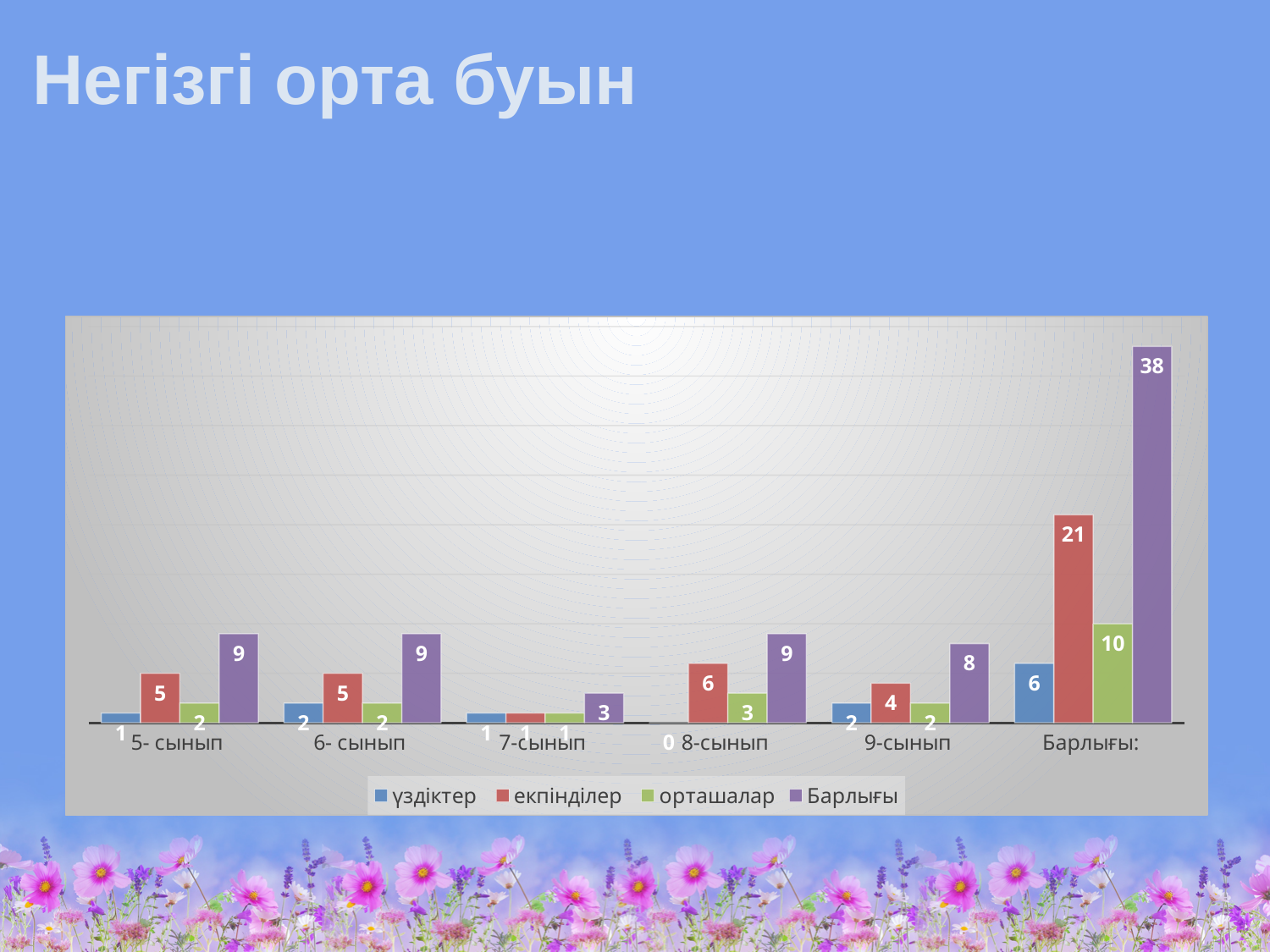
Which category has the highest екпінділер value? Барлығы: What is the value of екпінділер for 8-сынып? 6 How many categories are shown on the x axis? 6 How many series does the legend list? 4 What kind of chart is shown on the slide? bar chart What is the difference between the екпінділер and орташалар values for the Барлығы: category? 11 What is the value of үздіктер for 8-сынып? 0 Which is larger for 9-сынып: екпінділер or орташалар? екпінділер Which category has the lowest Барлығы value? 7-сынып What is the value of орташалар for the Барлығы: category? 10 What is the value of Барлығы for the Барлығы: category? 38 What is the title of the slide? Негізгі орта буын